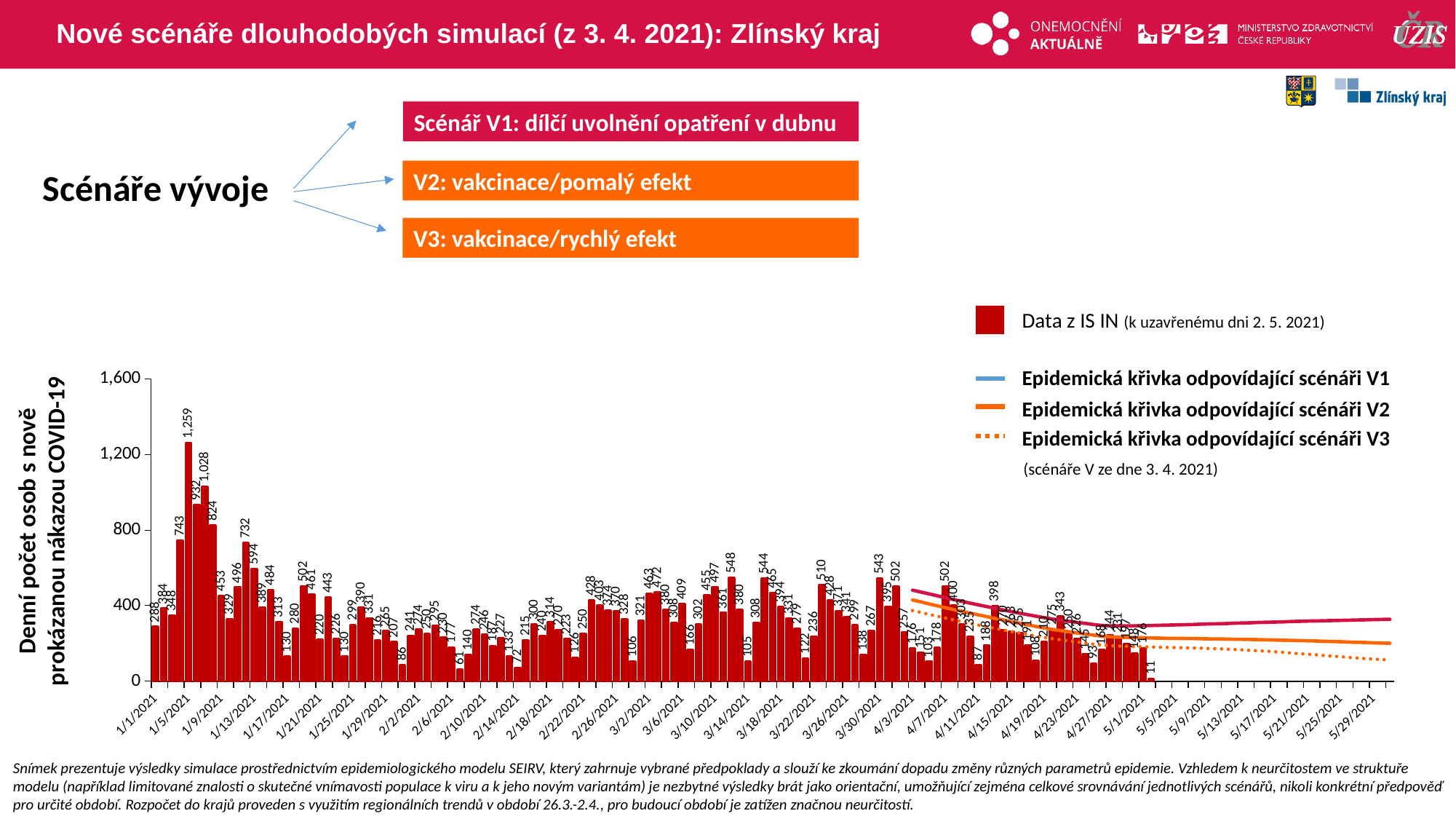
Is the highest bar on the chart greater or less than 1,200? greater What is the legend label for the red bars? Data z IS IN What type of chart is used to show the daily number of newly confirmed COVID-19 cases? bar chart How many scenario curves (V1, V2, V3) are listed in the legend? 3 Which is larger, the bar labelled 1,028 or the bar labelled 932? 1,028 What is the difference between the highest bar (1,259) and the bar labelled 1,028? 231 How many entries does the chart legend list? 4 From the peak in early January to the end of April, do the daily values generally rise or fall? fall What is the value of the first bar (1/1/2021) on the chart? 288 What is the highest daily value shown on the bar chart? 1,259 What is the highest tick value shown on the vertical axis? 1,600